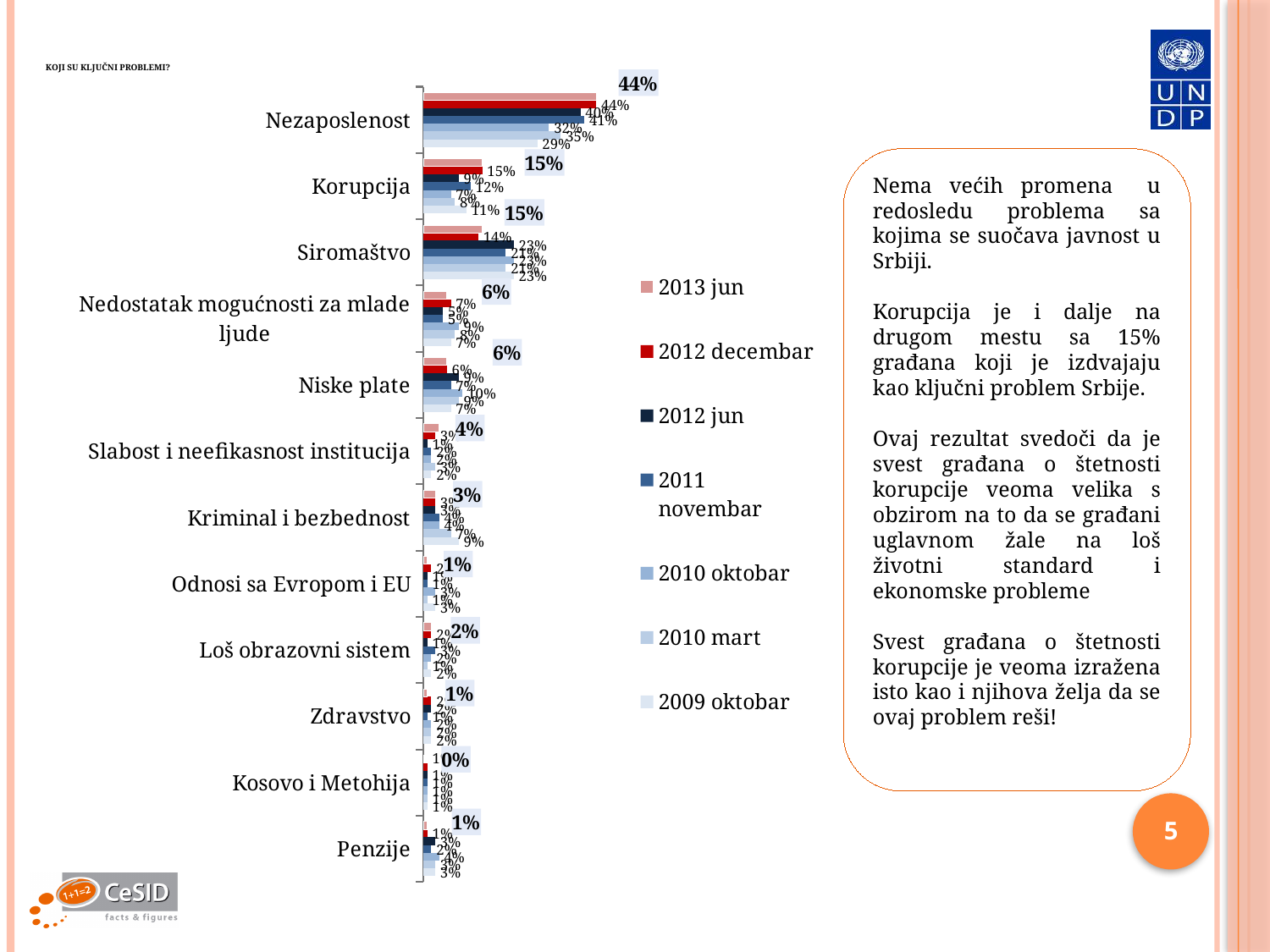
In the 2013 jun series, which is larger: Nezaposlenost or Korupcija? Nezaposlenost What is the difference between the 2013 jun values for Nezaposlenost and Korupcija? 29 percentage points Which category has the lowest value in the 2013 jun series? Kosovo i Metohija What is the value for Nezaposlenost in the 2013 jun series? 44% What is the value for Siromaštvo in the 2013 jun series? 15% Which series is listed last in the legend? 2009 oktobar What is the value for Kosovo i Metohija in the 2013 jun series? 0% How many problem categories are shown on the chart? 12 What is the value for Korupcija in the 2013 jun series? 15% How many series does the legend list? 7 Which category has the highest value in the 2013 jun series? Nezaposlenost What kind of chart is shown on the slide? bar chart